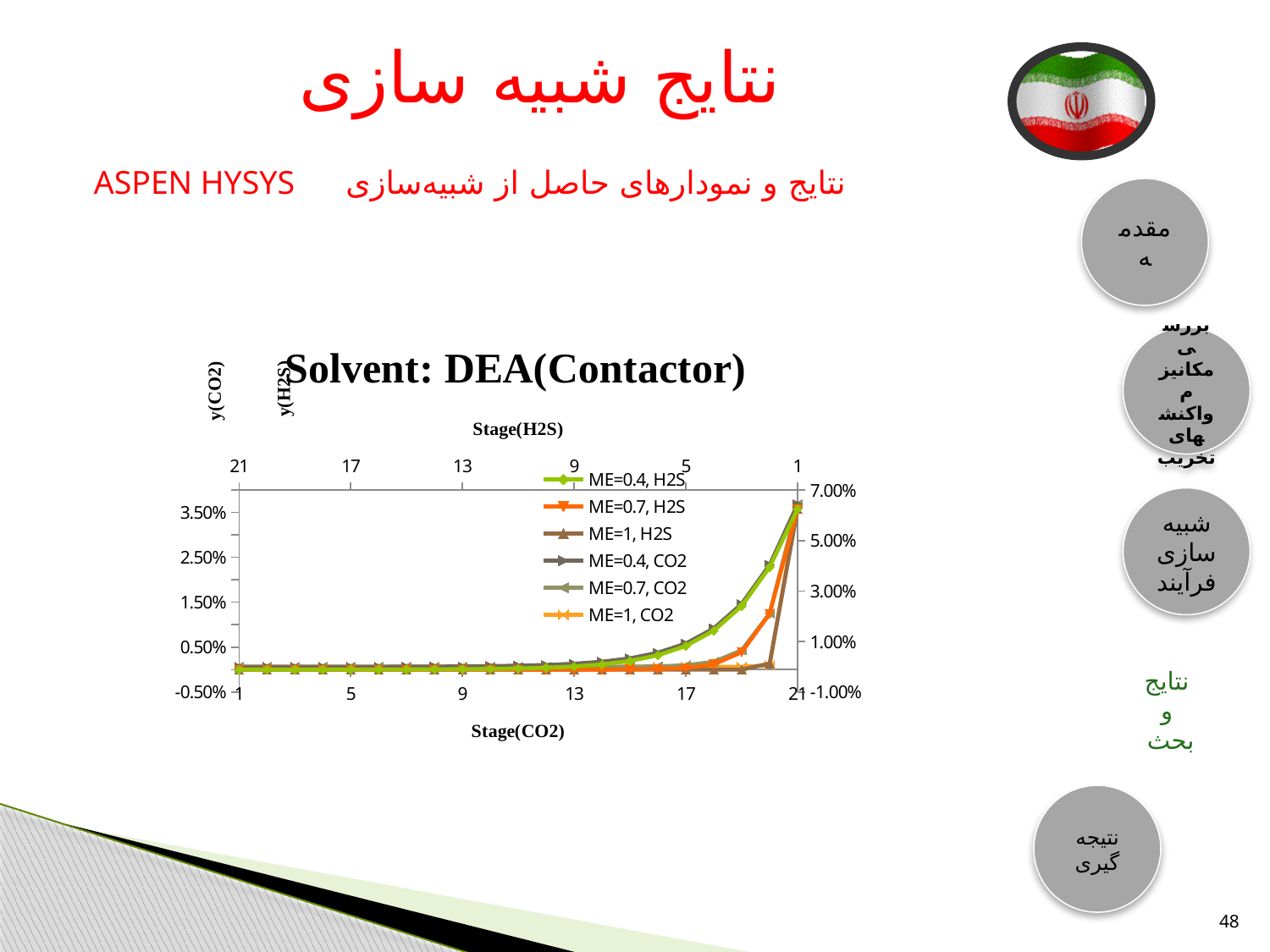
How many series does the legend of the chart list? 6 How many tick labels are shown on the bottom Stage(CO2) axis? 6 At stage 19 on the bottom axis, which is larger: the value for ME=0.7, H2S or the value for ME=1, H2S? ME=0.7, H2S What is the title of the bottom x axis of the chart? Stage(CO2) At stage 19 on the bottom axis, which is larger: the value for ME=0.4, H2S or the value for ME=1, H2S? ME=0.4, H2S What kind of chart is shown on the slide? line chart Is the value for ME=1, H2S at stage 13 on the bottom axis greater or less than 1.00% on the right axis? less Along the bottom Stage(CO2) axis, do the plotted values rise or fall from stage 1 to stage 21? rise What is the title of the chart? Solvent: DEA(Contactor)